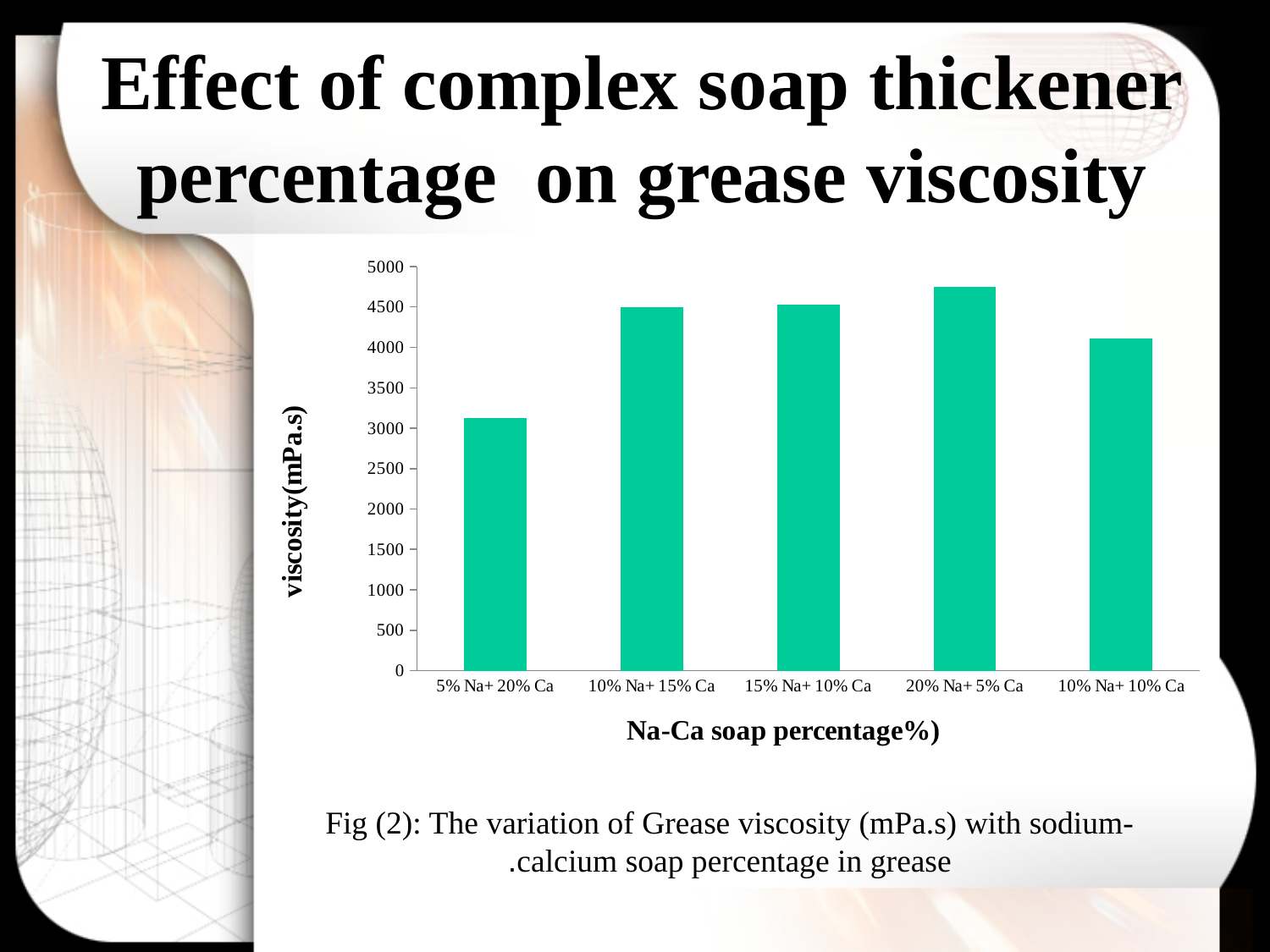
Is the viscosity for 10% Na+ 10% Ca greater or less than 4000? greater Which has a higher viscosity, 20% Na+ 5% Ca or 10% Na+ 10% Ca? 20% Na+ 5% Ca How many Na-Ca soap percentage categories are plotted in the chart? 5 Is the viscosity for 5% Na+ 20% Ca greater or less than 3500? less Is the viscosity for 15% Na+ 10% Ca greater or less than 4000? greater What kind of chart is shown on the slide? bar chart What is the maximum value shown on the vertical axis of the chart? 5000 Which Na-Ca soap percentage has the highest viscosity? 20% Na+ 5% Ca What is the label of the vertical axis of the chart? viscosity(mPa.s) Which has a lower viscosity, 5% Na+ 20% Ca or 10% Na+ 15% Ca? 5% Na+ 20% Ca Which Na-Ca soap percentage has the lowest viscosity? 5% Na+ 20% Ca